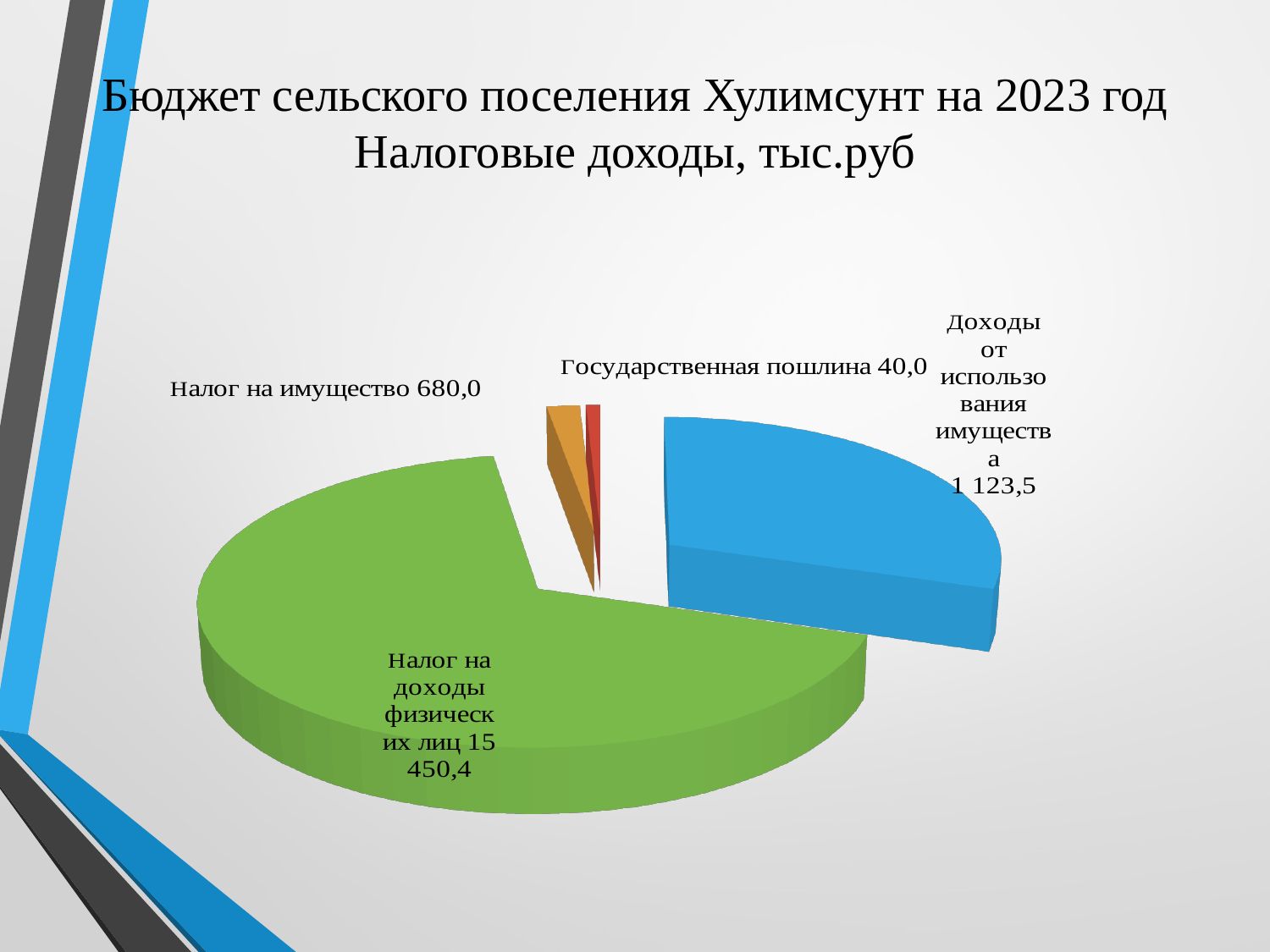
What is the difference between Доходы от использования имущества and Налог на имущество? 443,5 Which category has the smallest value? Государственная пошлина How many slices does the pie chart have? 4 What is the value for Налог на доходы физических лиц? 15 450,4 What type of chart is shown on the slide? pie chart Which is larger: Налог на имущество or Доходы от использования имущества? Доходы от использования имущества What is the total of all slices in the pie chart? 17 293,9 What is the value for Налог на имущество? 680,0 What is the difference between Налог на имущество and Государственная пошлина? 640,0 Which category has the largest value? Налог на доходы физических лиц What is the value for Государственная пошлина? 40,0 What is the value for Доходы от использования имущества? 1 123,5